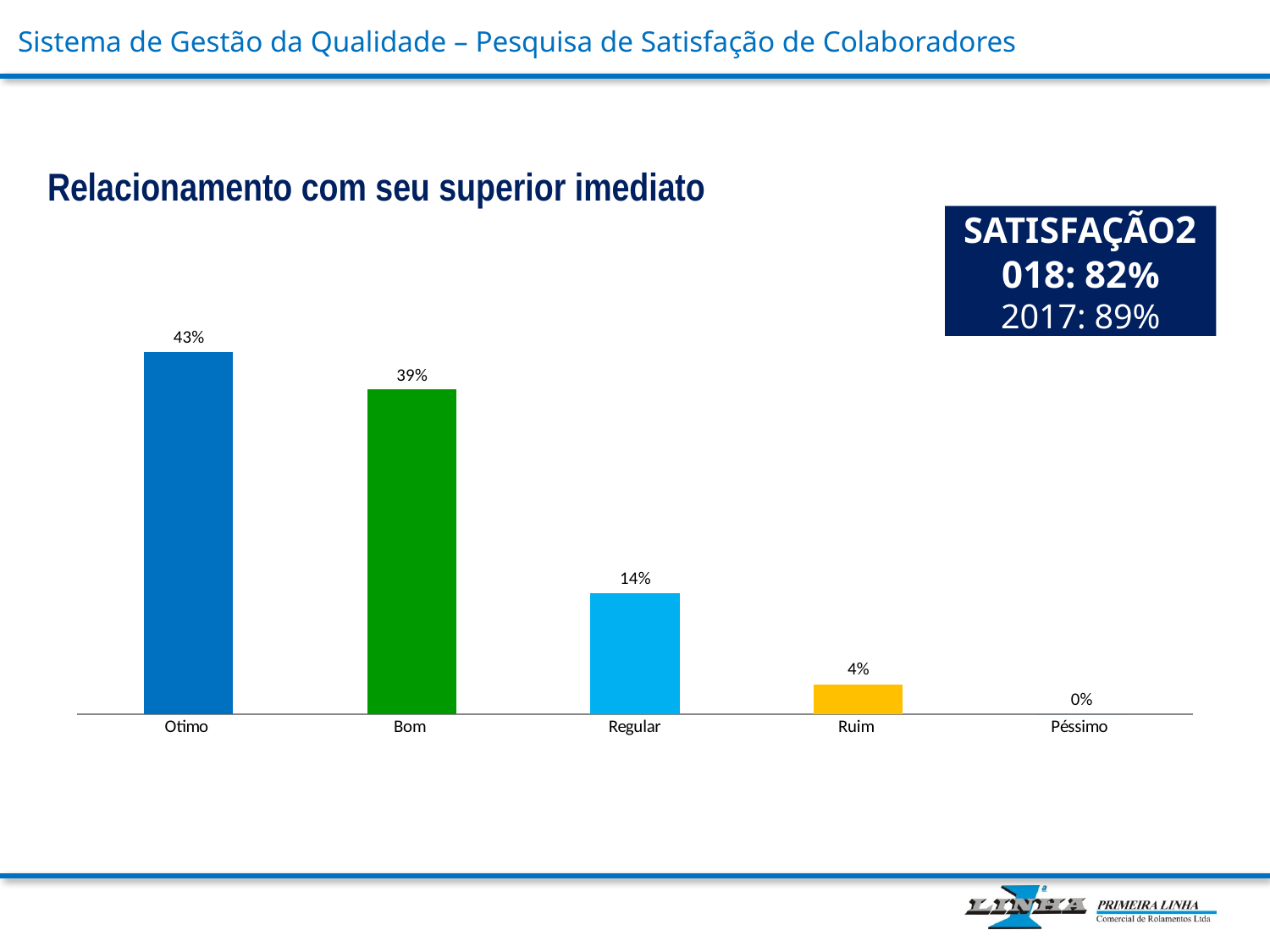
Which category has the highest value? Otimo What is the difference between the values for Otimo and Bom? 4% What is the value for Regular? 14% What is the difference between the values for Regular and Ruim? 10% How many categories are shown on the x axis? 5 What is the value for Péssimo? 0% What kind of chart is shown on the slide? Bar chart What is the value for Ruim? 4% Which is larger, the value for Bom or the value for Regular? Bom What is the value for Otimo? 43% Which category has the lowest value? Péssimo What is the value for Bom? 39%